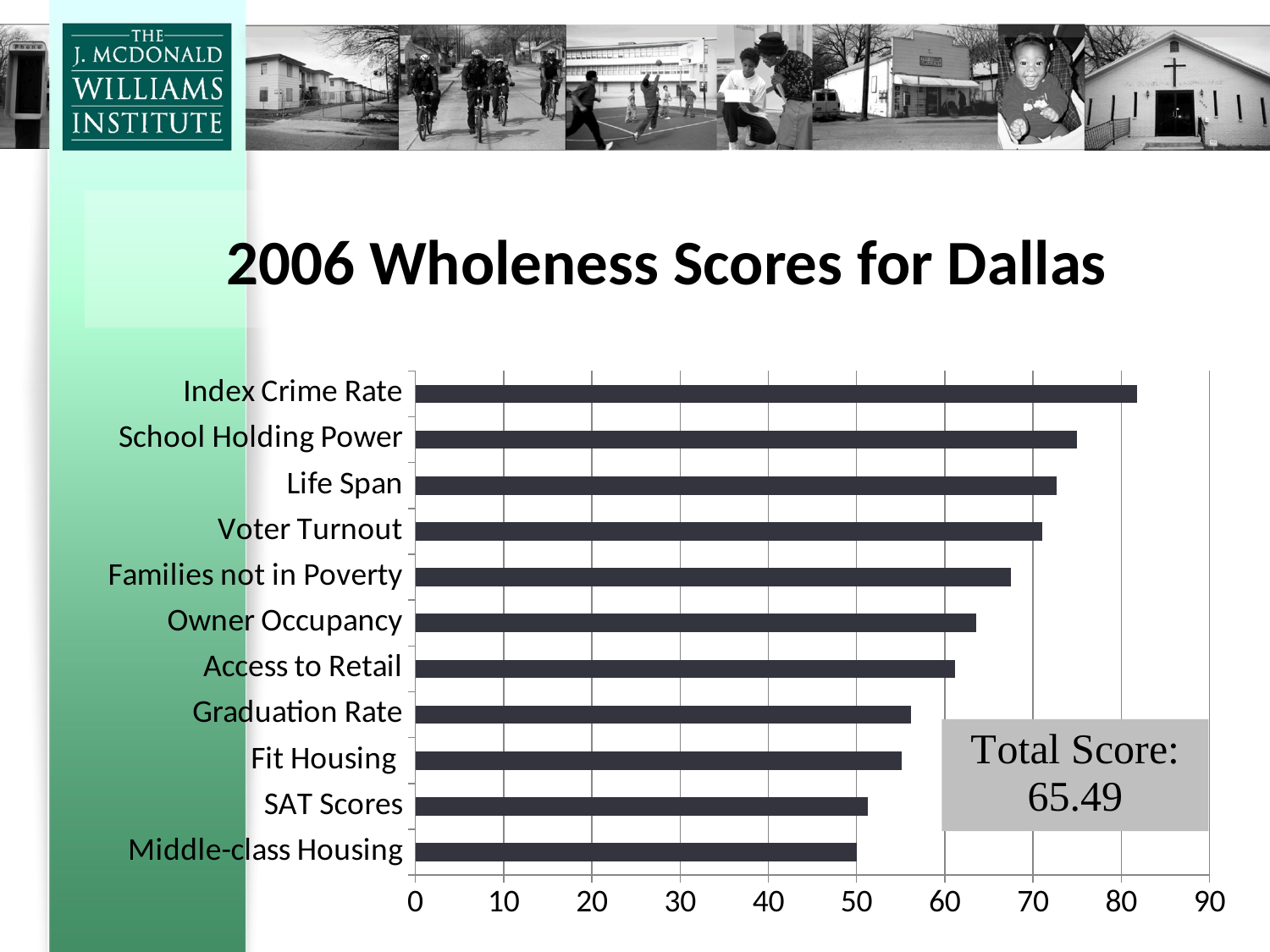
Is the value for School Holding Power greater or less than 70? greater What Total Score is printed on the chart? 65.49 Is the value for Index Crime Rate greater or less than 80? greater Which has a higher score, Voter Turnout or Access to Retail? Voter Turnout How many categories are plotted in the chart? 11 Which has a higher score, Index Crime Rate or Life Span? Index Crime Rate Is the value for Owner Occupancy greater or less than 60? greater What kind of chart is shown on the slide? bar chart What is the title of the slide's chart? 2006 Wholeness Scores for Dallas Which category has the highest score? Index Crime Rate